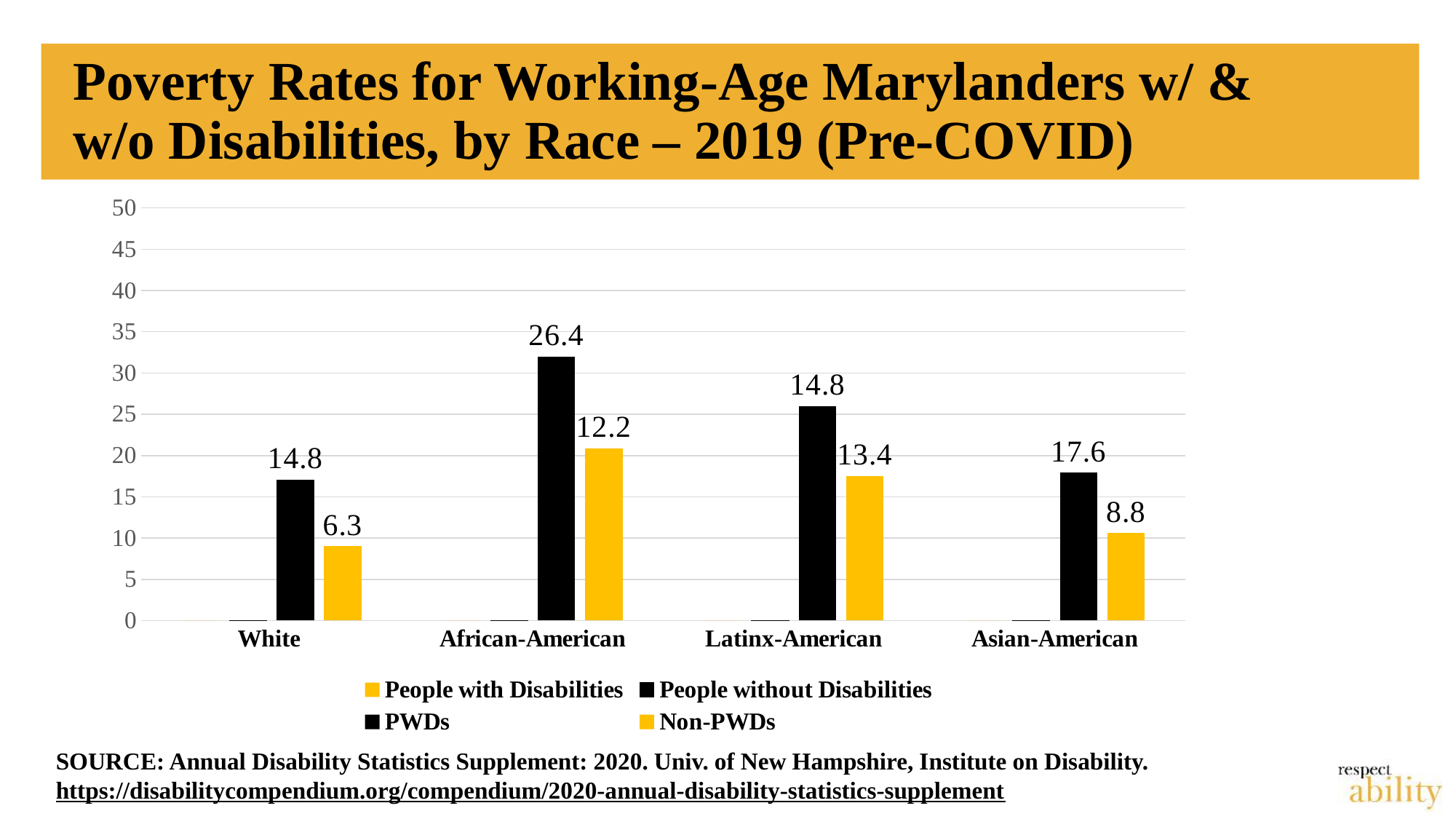
How many entries does the legend list? 4 Which race category has the highest labelled value on its black bar? African-American What is the title of the chart? Poverty Rates for Working-Age Marylanders w/ & w/o Disabilities, by Race – 2019 (Pre-COVID) What kind of chart is shown on the slide? bar chart For African-American, what is the difference between the black bar value and the yellow bar value? 14.2 What value is labelled on the black bar for Asian-American? 17.6 For White, which is larger: the black bar value or the yellow bar value? the black bar (14.8) What value is labelled on the yellow bar for Latinx-American? 13.4 What value is labelled on the black bar for African-American? 26.4 What value is labelled on the yellow bar for White? 6.3 How many race categories are shown on the x axis? 4 Which race category has the lowest labelled value on its yellow bar? White